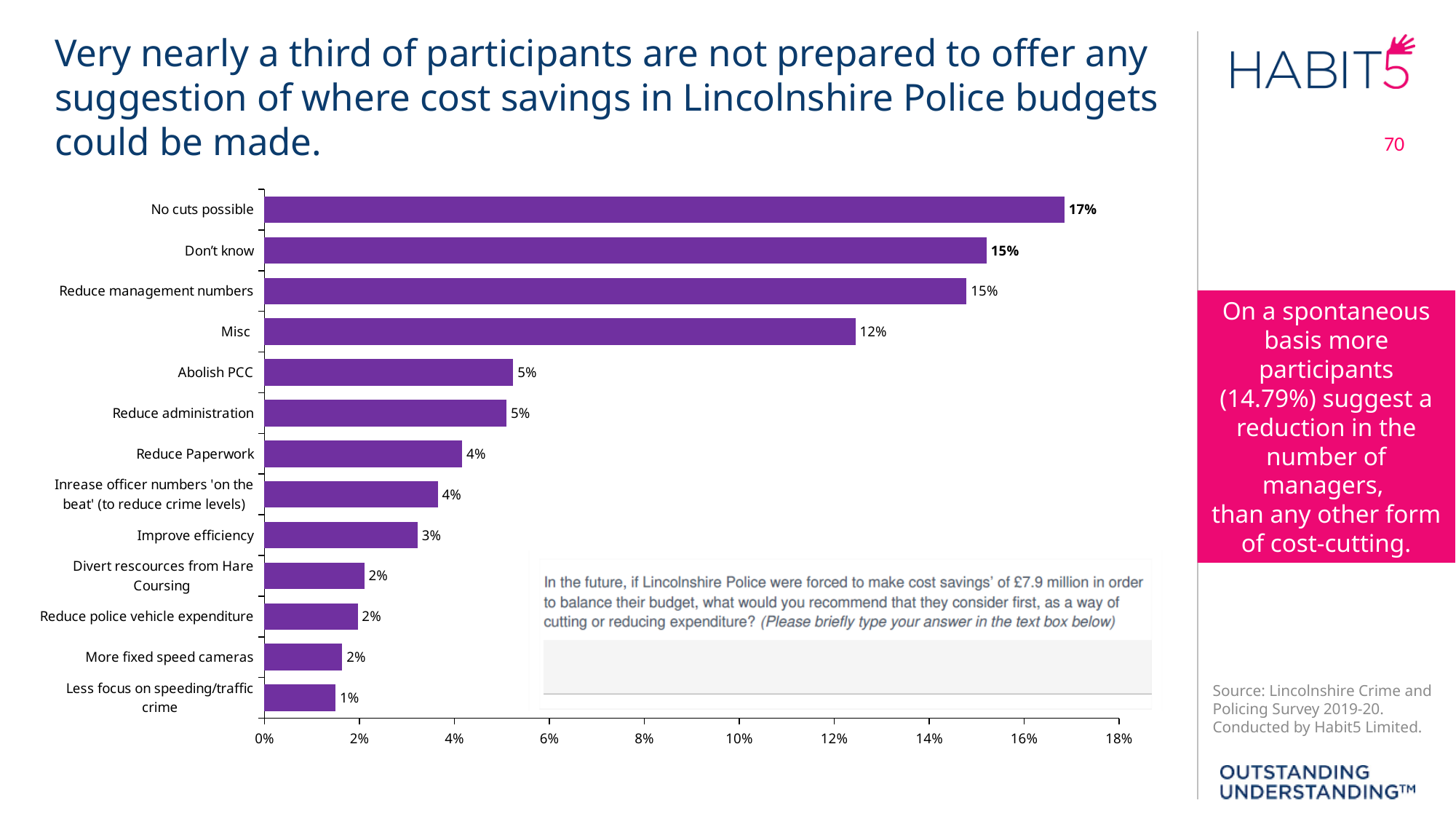
Is the value for 'Misc' greater or less than 10%? greater What is the value for 'Reduce Paperwork'? 4% How many categories are shown in the chart? 13 What kind of chart is shown on the slide? bar chart What is the value for 'Less focus on speeding/traffic crime'? 1% What is the value for 'Misc'? 12% Which category has the highest value? No cuts possible What is the difference between the values for 'No cuts possible' and 'Misc'? 5% What is the value for 'No cuts possible'? 17% What is the highest value shown on the horizontal axis? 18% Which category has the lowest value? Less focus on speeding/traffic crime Which is larger, the value for 'Misc' or the value for 'Abolish PCC'? Misc